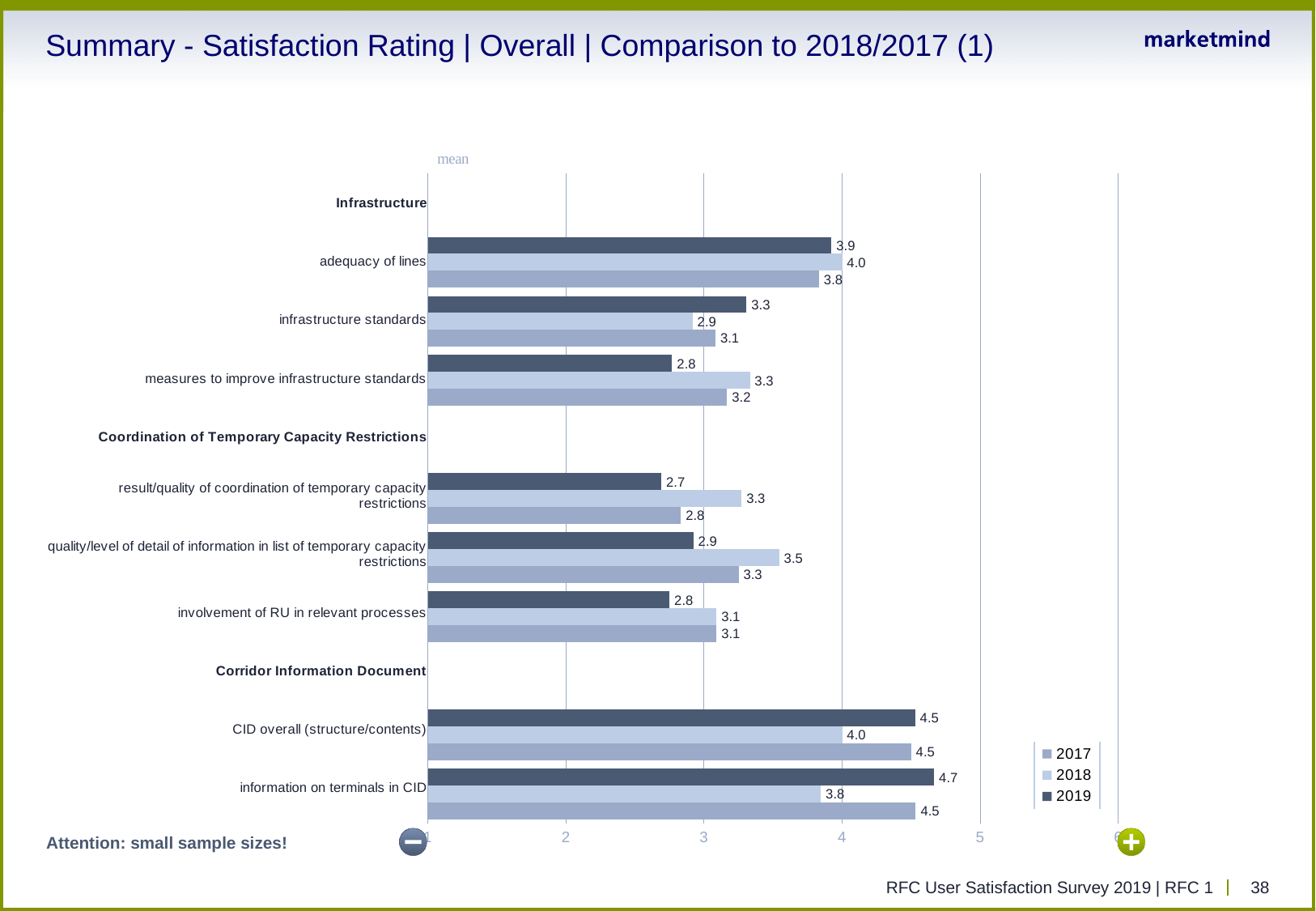
What is the 2019 mean satisfaction rating for adequacy of lines? 3.9 Which item has the lowest 2019 mean rating? result/quality of coordination of temporary capacity restrictions What is the 2018 mean rating for quality/level of detail of information in list of temporary capacity restrictions? 3.5 For measures to improve infrastructure standards, which year has the higher mean rating, 2018 or 2019? 2018 Is the 2019 mean rating for CID overall (structure/contents) greater or less than 4? greater Which item has the highest 2019 mean rating? information on terminals in CID How many series does the legend list? 3 What is the difference between the 2019 and 2018 mean ratings for information on terminals in CID? 0.9 What kind of chart is shown on the slide? bar chart How many items (excluding section headings) have bars plotted in the chart? 8 What is the 2017 mean rating for information on terminals in CID? 4.5 Which year is represented by the darkest bars in the chart? 2019